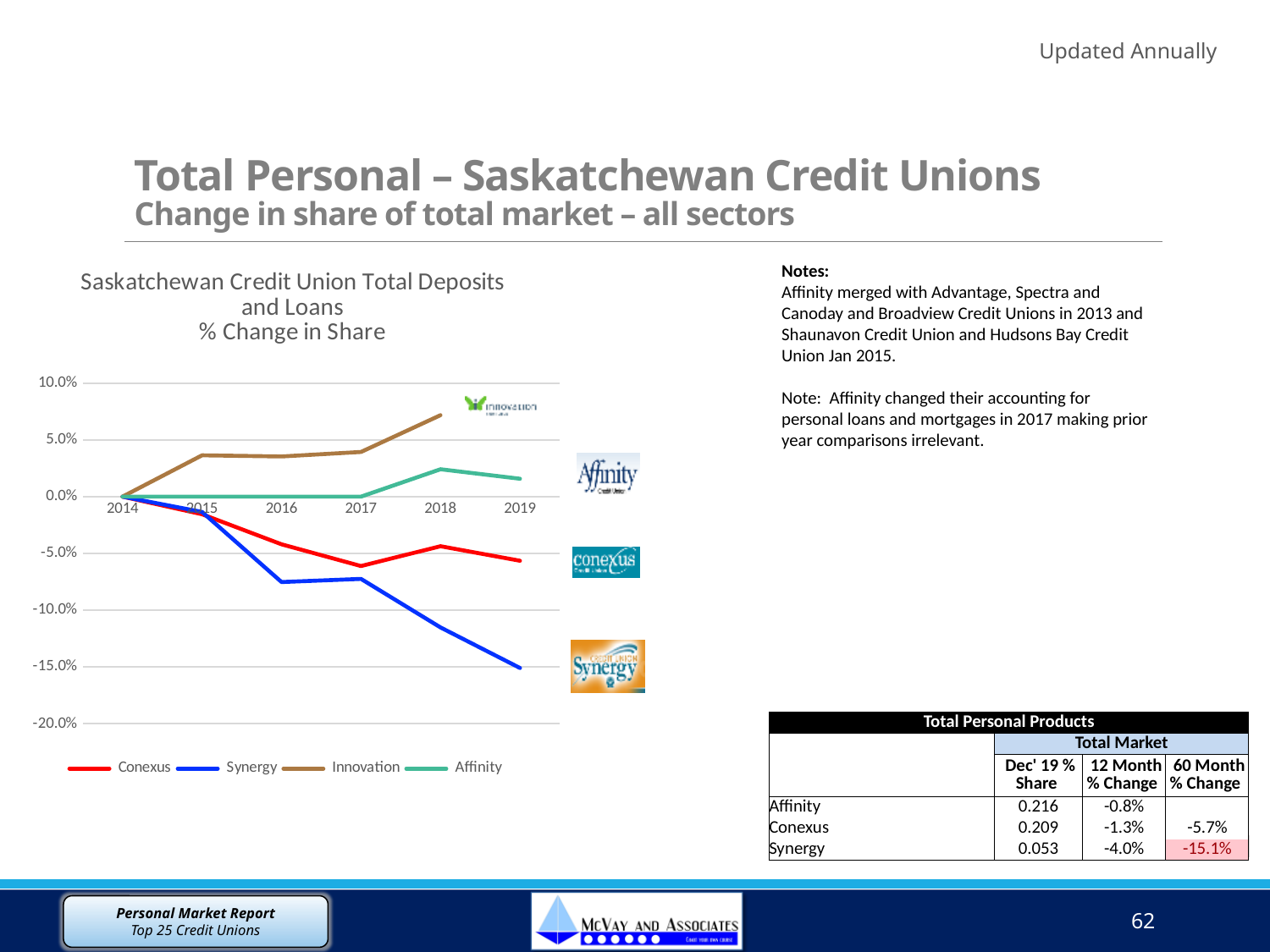
How many years are shown along the x axis of the chart? 6 Does the Synergy line rise or fall from 2014 to 2019? fall In 2016, which is larger: the value for Conexus or the value for Synergy? Conexus Does the Innovation line rise or fall from 2014 to 2018? rise What kind of chart is shown on the slide? line chart Is the value for Conexus in 2017 greater or less than -5.0%? less Is the value for Synergy in 2019 greater or less than -10.0%? less How many series does the chart legend list? 4 Is the value for Innovation in 2018 greater or less than 5.0%? greater Which credit union has the highest % change in share in 2018? Innovation Which credit union has the lowest % change in share in 2019? Synergy What colour is the Synergy line in the chart? blue